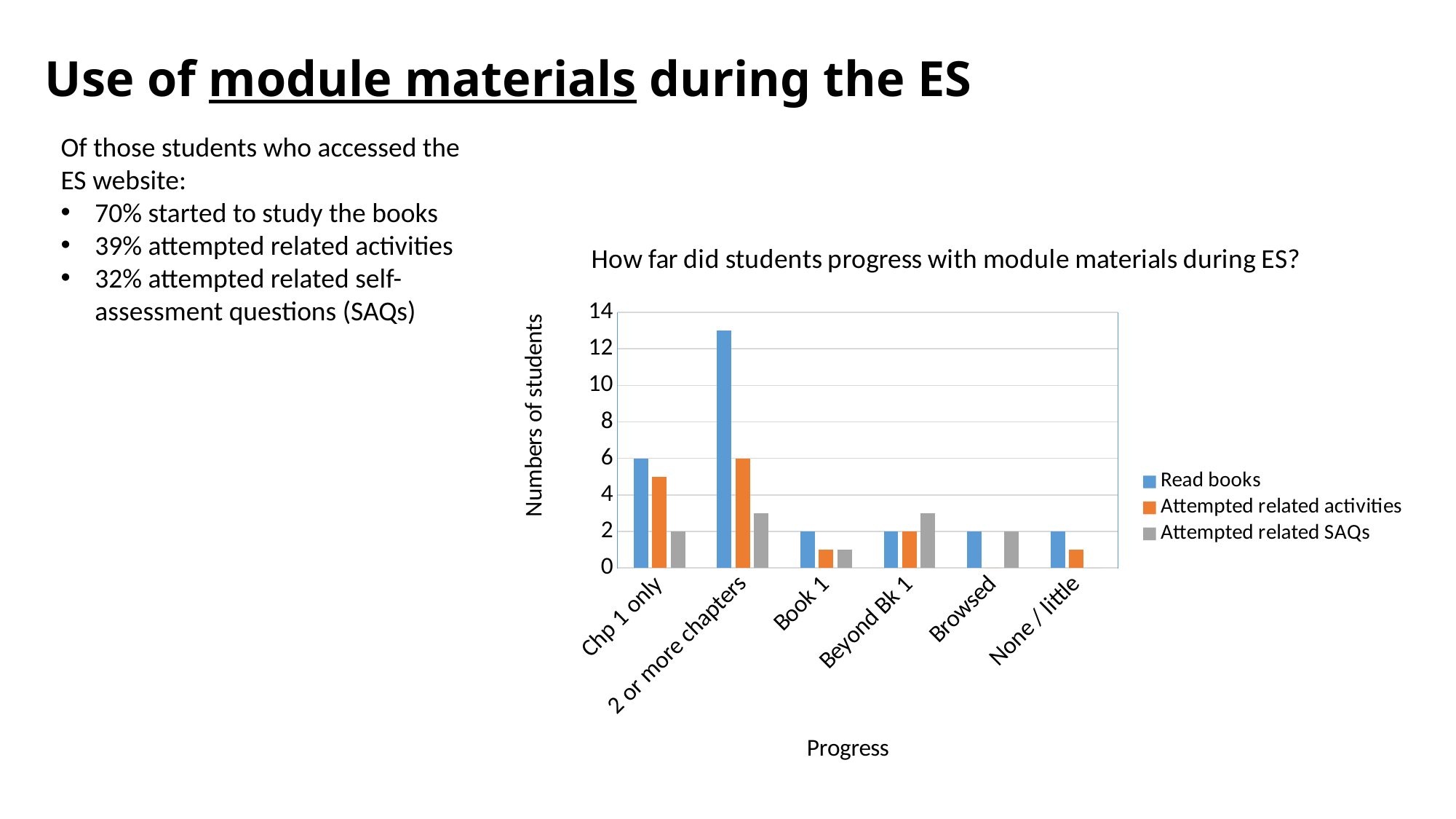
What kind of chart is shown on the slide? bar chart Which category has the highest value for Read books? 2 or more chapters Which is larger in the Beyond Bk 1 category: Read books or Attempted related SAQs? Attempted related SAQs How many series does the chart legend list? 3 Is the value for Read books in the 2 or more chapters category greater or less than 12? greater What is the value for Read books in the Chp 1 only category? 6 What is the difference between Read books in the Chp 1 only category and Read books in the Book 1 category? 4 What is the value for Attempted related activities in the 2 or more chapters category? 6 Is the value for Attempted related activities in the Book 1 category greater or less than 2? less What is the value for Attempted related SAQs in the Chp 1 only category? 2 What is the title of the chart? How far did students progress with module materials during ES? How many progress categories are shown on the x axis of the chart? 6